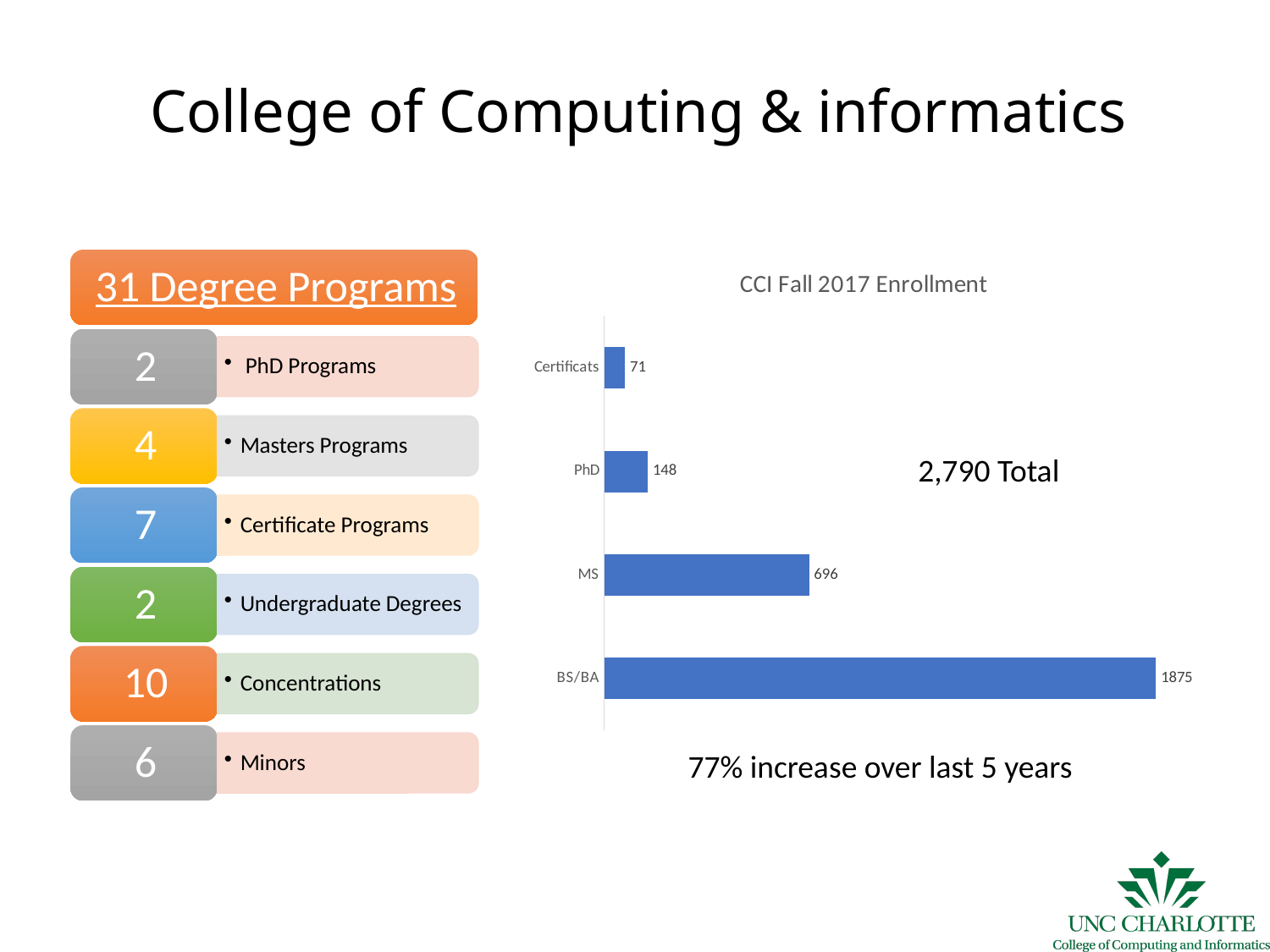
What is the enrollment value for MS? 696 Which category has the highest enrollment? BS/BA What is the difference between the PhD and Certificats enrollment values? 77 What is the enrollment value for Certificats? 71 Which category has the lowest enrollment? Certificats What is the enrollment value for BS/BA? 1875 What type of chart is shown on the slide? bar chart What is the difference between the BS/BA and MS enrollment values? 1179 Which is larger, the enrollment for MS or for PhD? MS What is the enrollment value for PhD? 148 What is the title of the chart? CCI Fall 2017 Enrollment How many categories are shown in the chart? 4